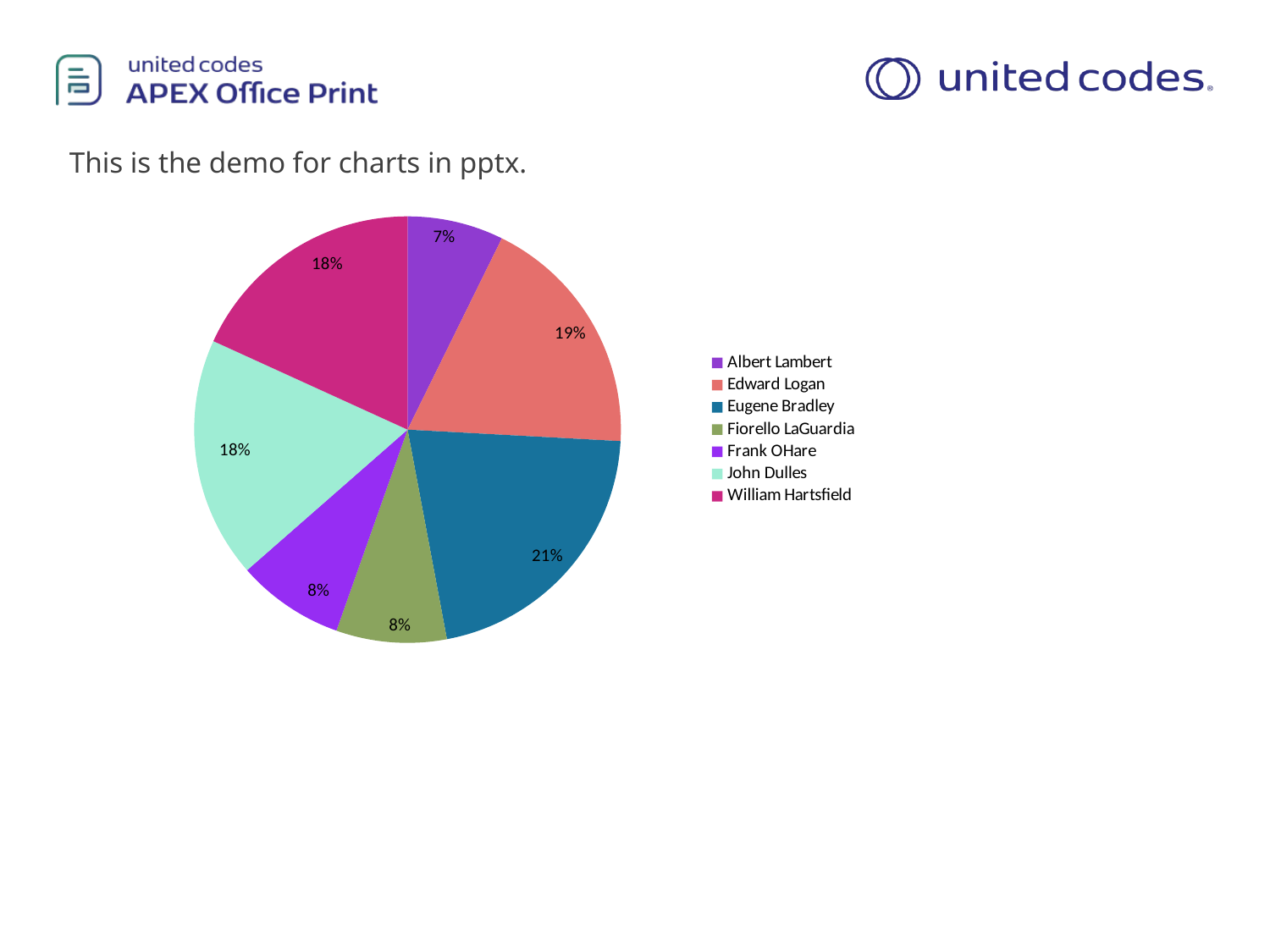
What share of the pie does John Dulles have? 18% What share of the pie does Albert Lambert have? 7% Which slice is larger, William Hartsfield or Frank OHare? William Hartsfield Which category has the largest slice of the pie? Eugene Bradley What kind of chart is shown on the slide? Pie chart What share of the pie does Eugene Bradley have? 21% Which legend entry is listed last? William Hartsfield Which category has the smallest slice of the pie? Albert Lambert How many categories does the pie chart show? 7 What is the difference in percentage points between the Eugene Bradley slice and the Albert Lambert slice? 14